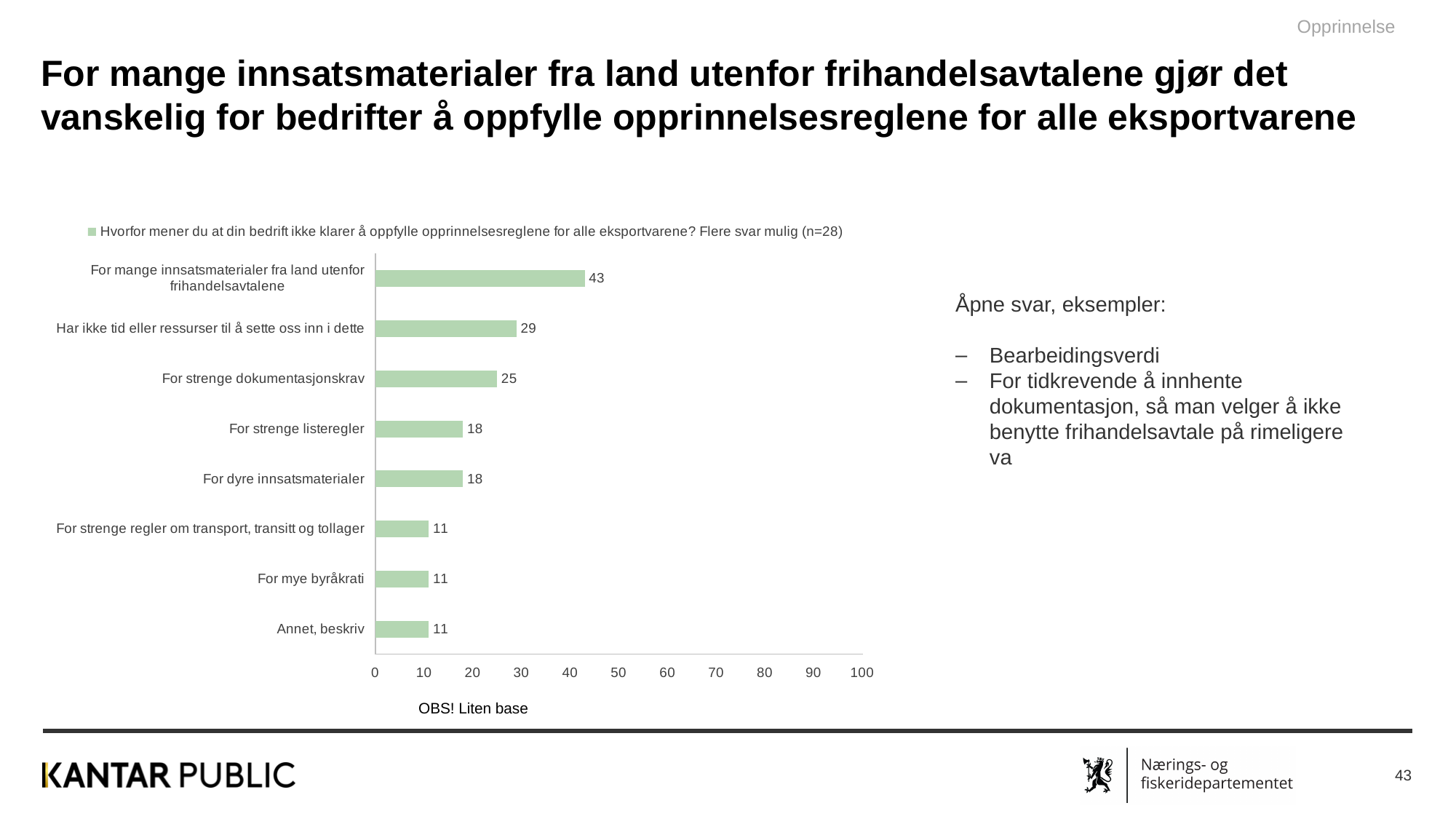
What is the value for "For strenge dokumentasjonskrav"? 25 What kind of chart is shown on the slide? Bar chart What is the value for "Har ikke tid eller ressurser til å sette oss inn i dette"? 29 What is the value for "For mye byråkrati"? 11 Which category has the highest value? For mange innsatsmaterialer fra land utenfor frihandelsavtalene What is the difference between the values for "For mange innsatsmaterialer fra land utenfor frihandelsavtalene" and "Har ikke tid eller ressurser til å sette oss inn i dette"? 14 Is the value for "For dyre innsatsmaterialer" greater or less than 20? less How many series does the legend list? 1 What is the maximum value shown on the x axis? 100 How many categories are shown in the chart? 8 What is the value for "For mange innsatsmaterialer fra land utenfor frihandelsavtalene"? 43 Which is larger, the value for "For strenge dokumentasjonskrav" or the value for "For strenge listeregler"? For strenge dokumentasjonskrav